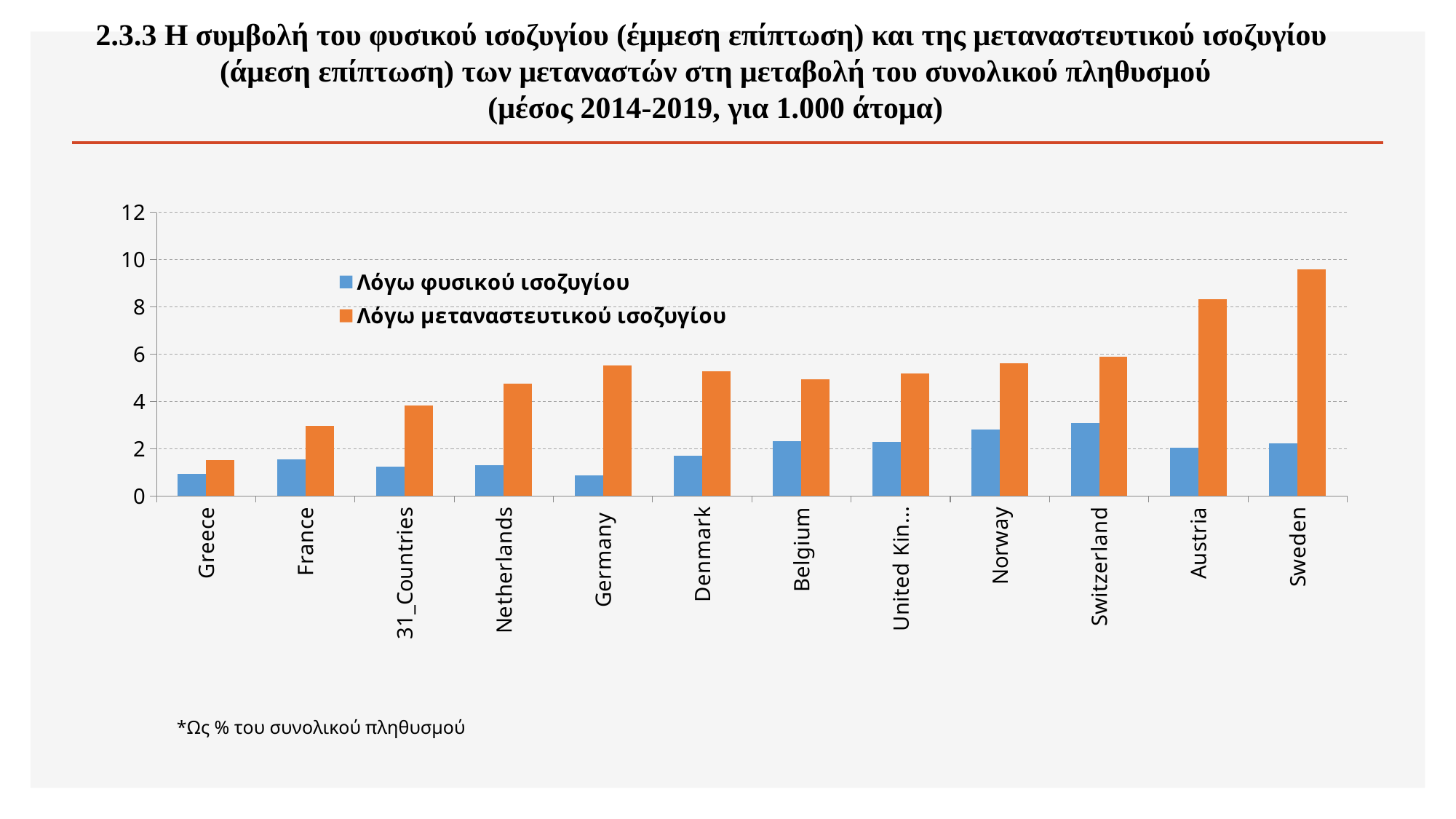
Which is larger for Λόγω μεταναστευτικού ισοζυγίου: Sweden or Austria? Sweden Which colour represents the Λόγω μεταναστευτικού ισοζυγίου series? orange Which category has the lowest value for Λόγω μεταναστευτικού ισοζυγίου? Greece How many series does the legend list? 2 Is the value for Switzerland in the Λόγω φυσικού ισοζυγίου series greater or less than 2? greater Is the value for Germany in the Λόγω φυσικού ισοζυγίου series greater or less than 2? less Which category has the highest value for Λόγω μεταναστευτικού ισοζυγίου? Sweden How many countries/categories are shown on the x axis? 12 What kind of chart is shown on the slide? bar chart Which is larger for Λόγω φυσικού ισοζυγίου: Belgium or Germany? Belgium Is the value for Sweden in the Λόγω μεταναστευτικού ισοζυγίου series greater or less than 8? greater